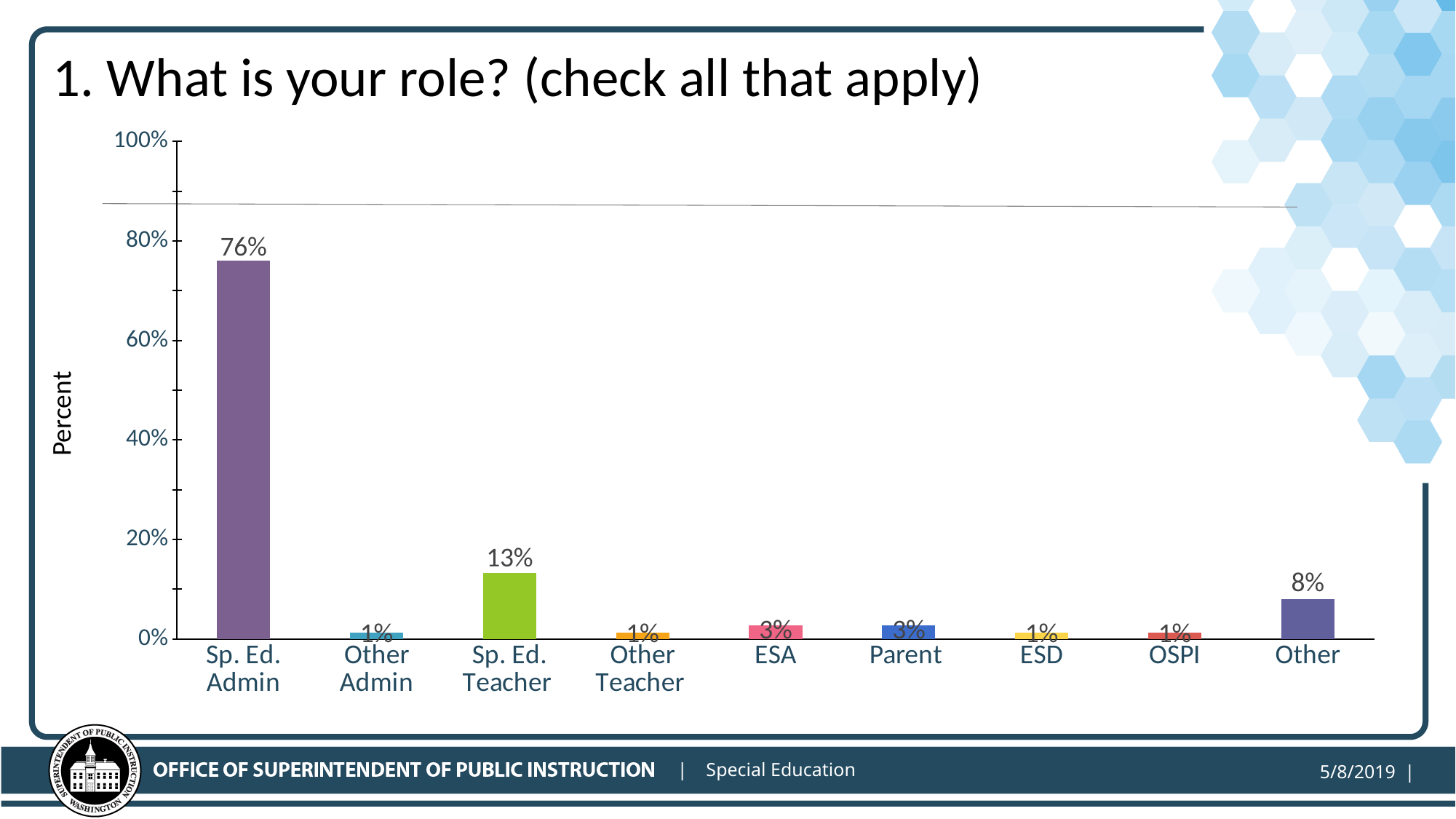
What is the label on the vertical axis? Percent What type of chart is shown on the slide? bar chart What percentage is shown for Parent? 3% What is the value shown for the Other category? 8% What percentage of respondents selected Sp. Ed. Admin as their role? 76% How many role categories are shown on the x axis? 9 Which role has the highest percentage? Sp. Ed. Admin What percentage of respondents selected Sp. Ed. Teacher? 13% Is the value for Sp. Ed. Admin greater or less than 60%? greater What is the difference between the Sp. Ed. Teacher and Other percentages? 5% Which is larger, the value for ESA or the value for ESD? ESA What is the difference between the Sp. Ed. Admin and Sp. Ed. Teacher percentages? 63%